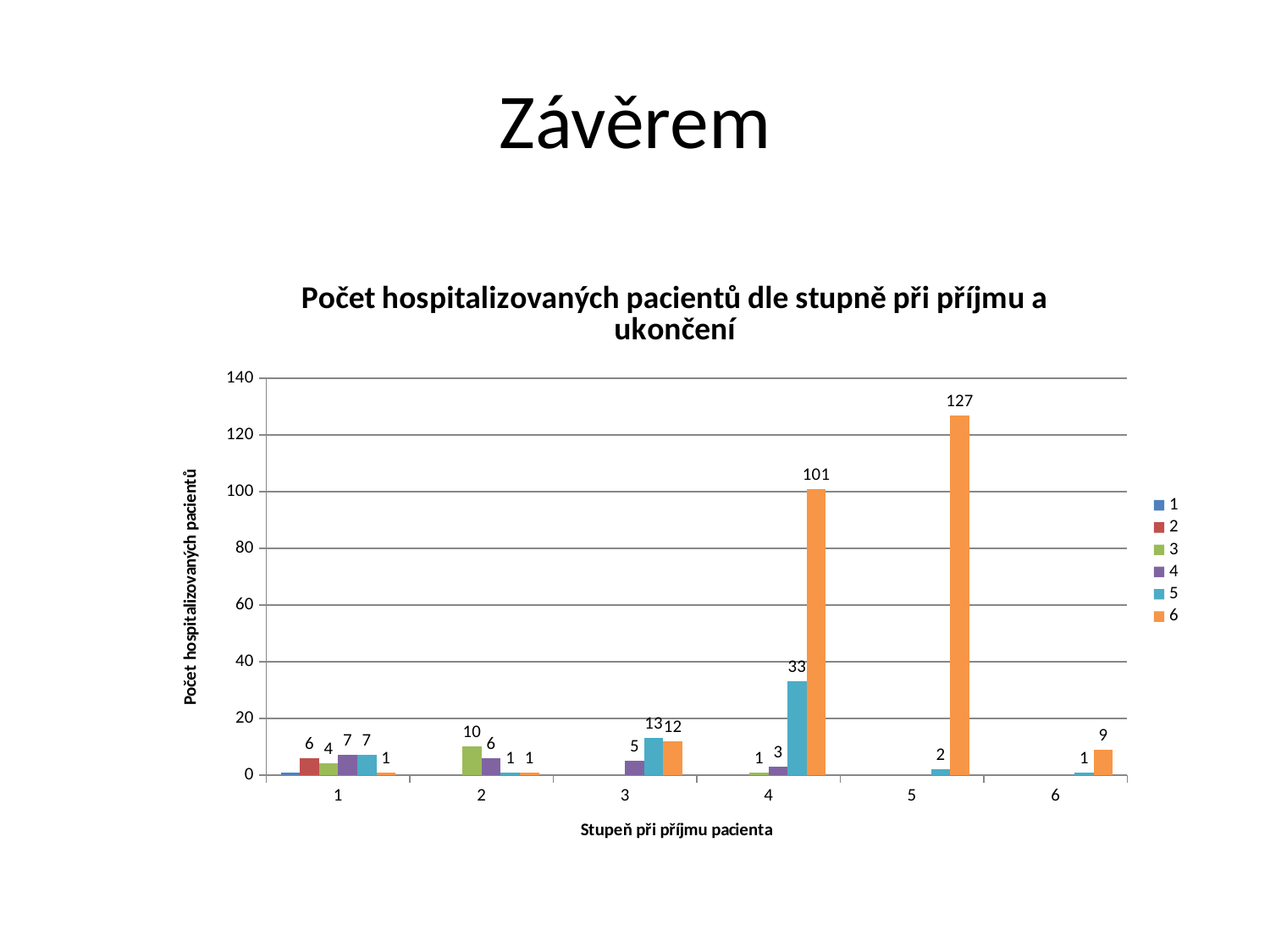
What is the value for series 3 at category 2? 10 What type of chart is shown on the slide? bar chart Which category has the highest value for series 6? 5 Which is larger at category 3: series 5 or series 6? series 5 How many categories are shown on the x axis? 6 What is the difference between the series 6 values at category 5 and category 4? 26 What is the title of the x axis? Stupeň při příjmu pacienta What is the value for series 6 at category 5? 127 Is the value for series 6 at category 5 greater or less than 120? greater How many series does the legend list? 6 What is the value for series 6 at category 4? 101 What is the value for series 5 at category 4? 33